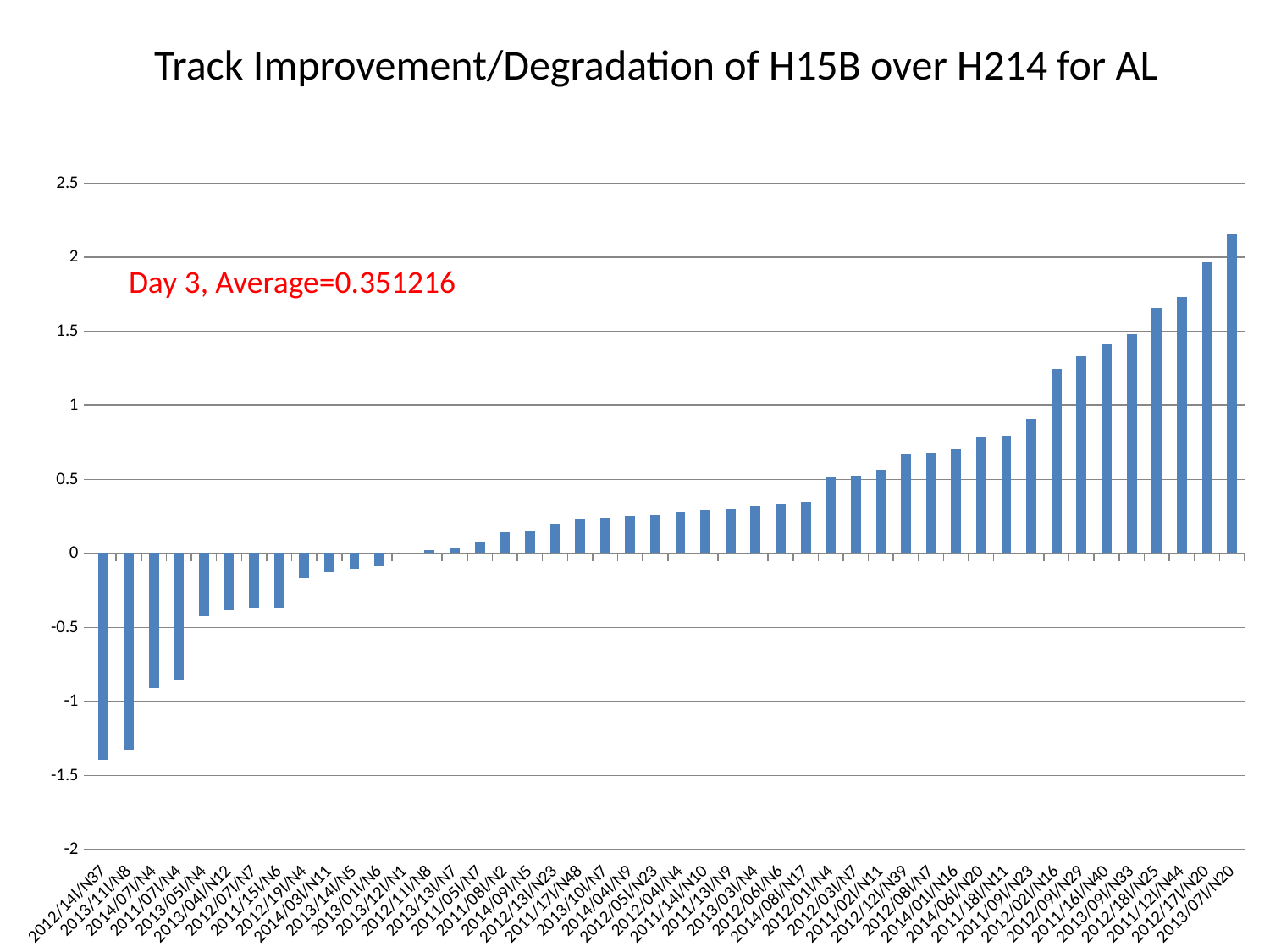
What kind of chart is shown on the slide? bar chart Which is larger, the value for 2013/11/N8 or the value for 2011/12/N44? 2011/12l/N44 Is the value for 2012/14/N37 greater or less than -1? less Which category has the highest value? 2013/07l/N20 What does the red annotation on the chart say? Day 3, Average=0.351216 Do the values rise or fall from left to right along the x axis? rise What is the highest value shown on the vertical axis? 2.5 Is the value for 2013/07/N20 greater or less than 2? greater Is the value for 2011/07/N4 greater or less than -0.5? less Which category has the lowest value? 2012/14l/N37 What is the title of the chart? Track Improvement/Degradation of H15B over H214 for AL